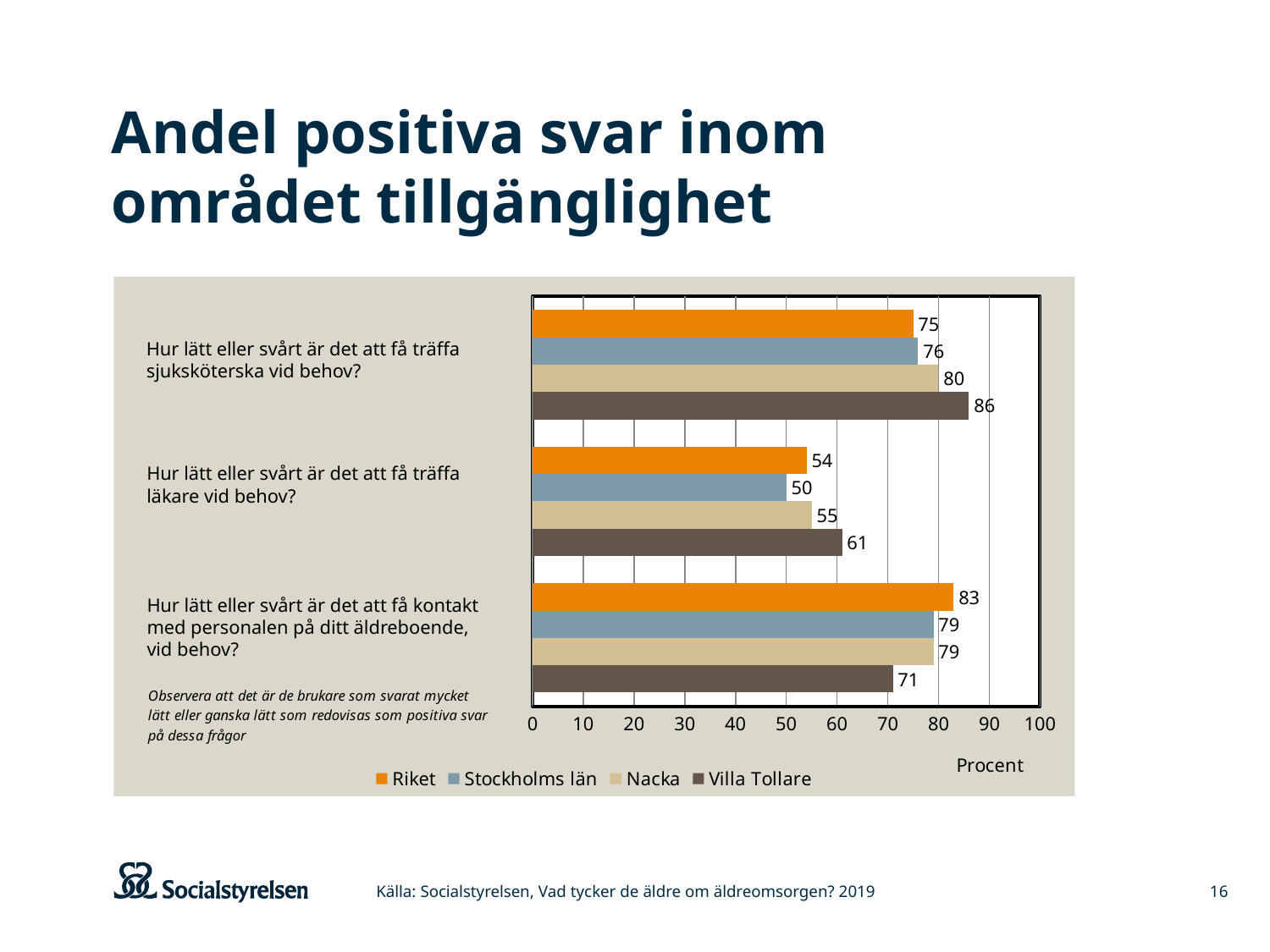
How many series does the legend list? 4 What kind of chart is shown on the slide? Bar chart What is the value for Villa Tollare on the question "Hur lätt eller svårt är det att få träffa sjuksköterska vid behov?"? 86 What is the value for Riket on the question "Hur lätt eller svårt är det att få kontakt med personalen på ditt äldreboende, vid behov?"? 83 How many questions (categories) are shown on the chart? 3 What is the value for Stockholms län on the question "Hur lätt eller svårt är det att få träffa läkare vid behov?"? 50 Which series is shown in orange in the legend? Riket What is the label of the x axis? Procent Which series has the highest value on the question "Hur lätt eller svårt är det att få träffa läkare vid behov?"? Villa Tollare What is the difference between Villa Tollare and Riket on the question "Hur lätt eller svårt är det att få träffa sjuksköterska vid behov?"? 11 Which series has the lowest value on the question "Hur lätt eller svårt är det att få kontakt med personalen på ditt äldreboende, vid behov?"? Villa Tollare Which is larger on the question "Hur lätt eller svårt är det att få träffa läkare vid behov?": Riket or Nacka? Nacka